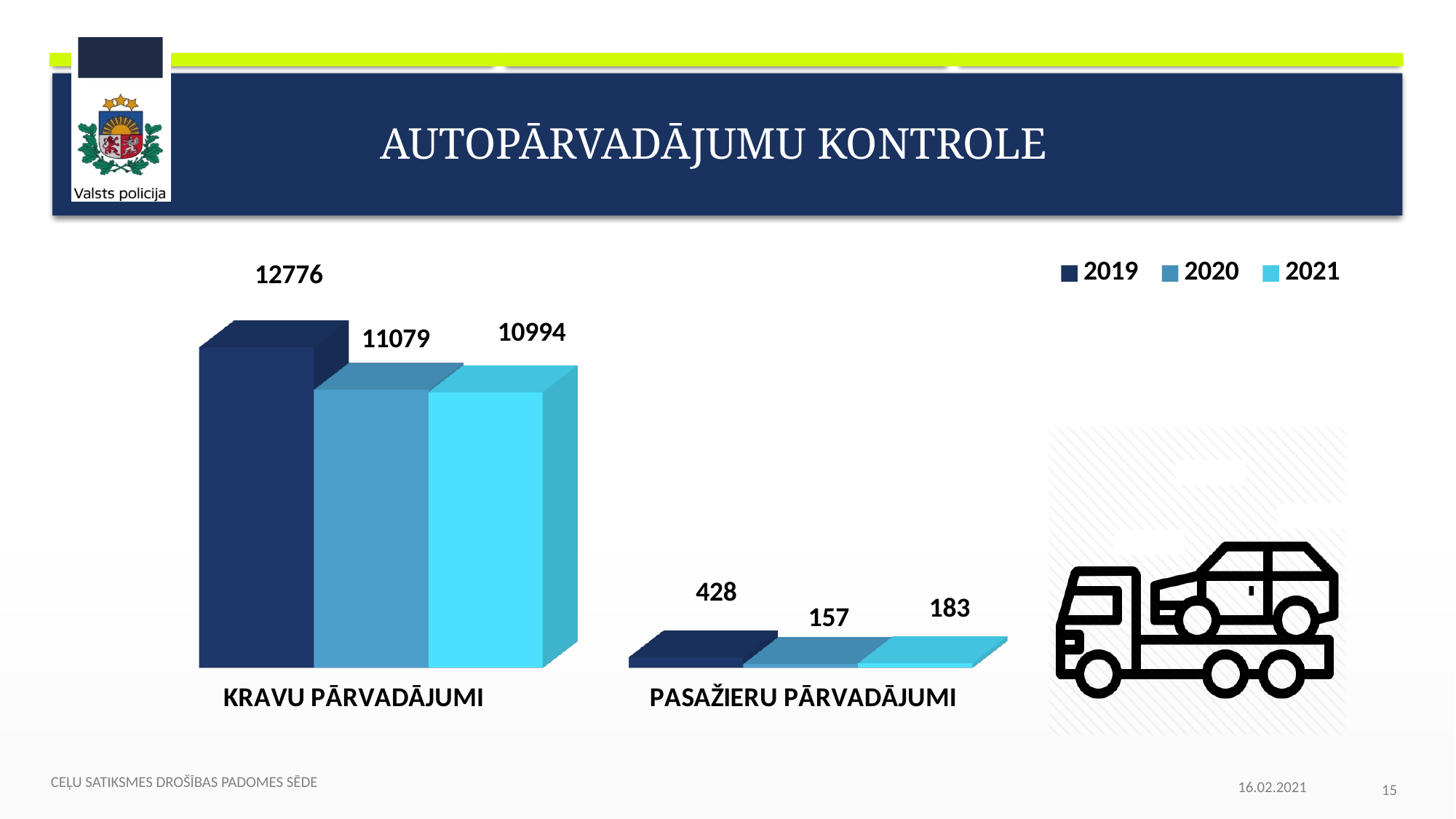
What is the value for 2021 in the PASAŽIERU PĀRVADĀJUMI category? 183 What is the difference between the 2019 and 2021 values for KRAVU PĀRVADĀJUMI? 1782 How many series does the legend list? 3 What is the value for 2020 in the KRAVU PĀRVADĀJUMI category? 11079 What is the value for 2020 in the PASAŽIERU PĀRVADĀJUMI category? 157 What is the value for 2019 in the KRAVU PĀRVADĀJUMI category? 12776 What kind of chart is shown on the slide? Bar chart What is the difference between the 2019 and 2020 values for PASAŽIERU PĀRVADĀJUMI? 271 Which year has the highest value in the KRAVU PĀRVADĀJUMI category? 2019 How many categories are shown on the x axis? 2 Which is larger for PASAŽIERU PĀRVADĀJUMI: the 2020 value or the 2021 value? 2021 Which year has the lowest value in the PASAŽIERU PĀRVADĀJUMI category? 2020